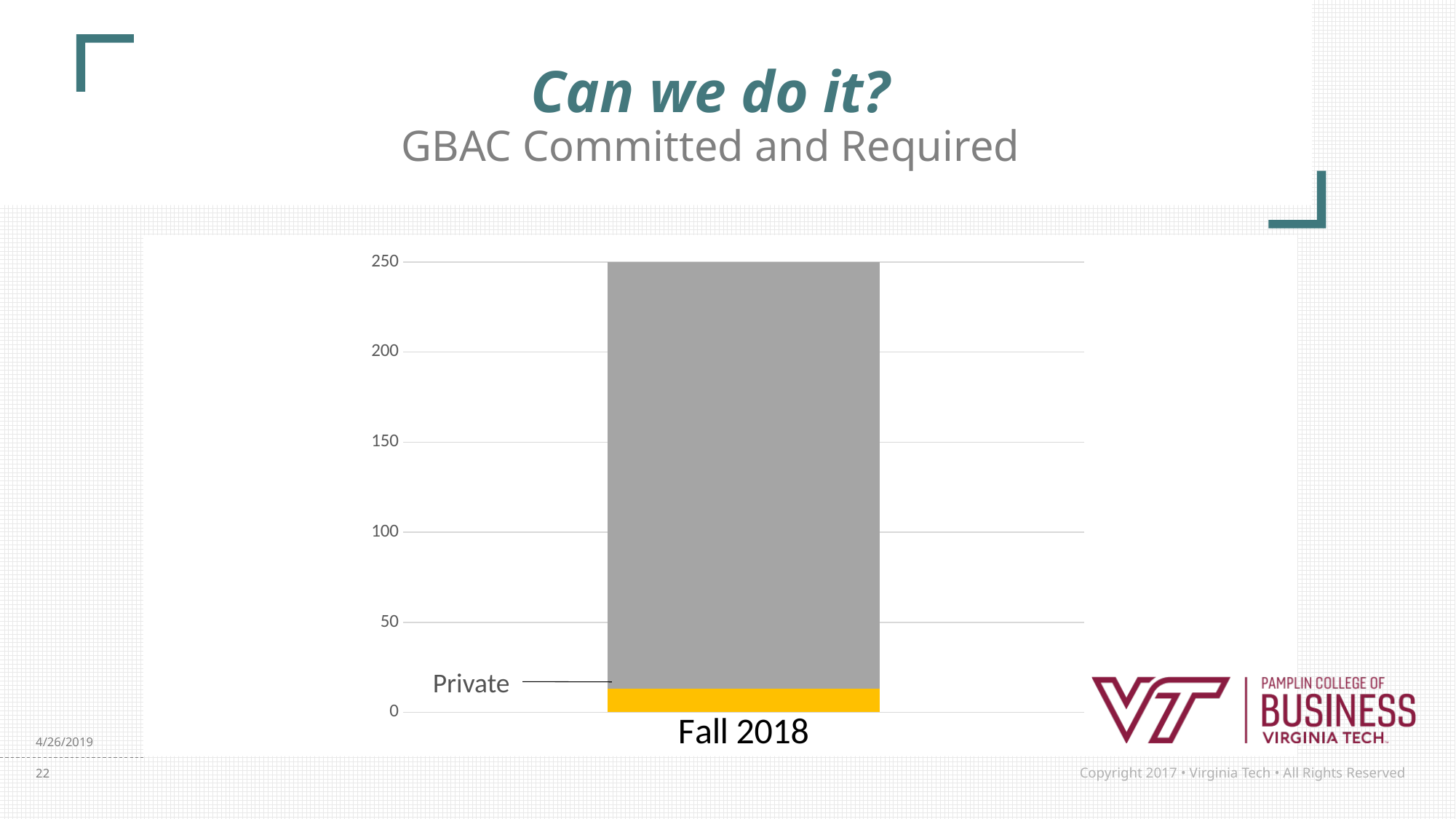
What is the total height of the stacked bar for Fall 2018, as read from the axis tick it reaches? 250 Is the gray segment of the Fall 2018 bar greater or less than 150? greater Is the total height of the Fall 2018 bar greater or less than 200? greater How many categories are shown on the x axis of the chart? 1 What colour is the segment labelled Private in the chart? yellow What kind of chart is shown on the slide? bar chart What is the category label on the x axis of the chart? Fall 2018 Is the value of the Private segment for Fall 2018 greater or less than 50? less Which segment of the Fall 2018 bar is larger, the gray segment or the Private segment? the gray segment What is the highest value shown on the vertical axis of the chart? 250